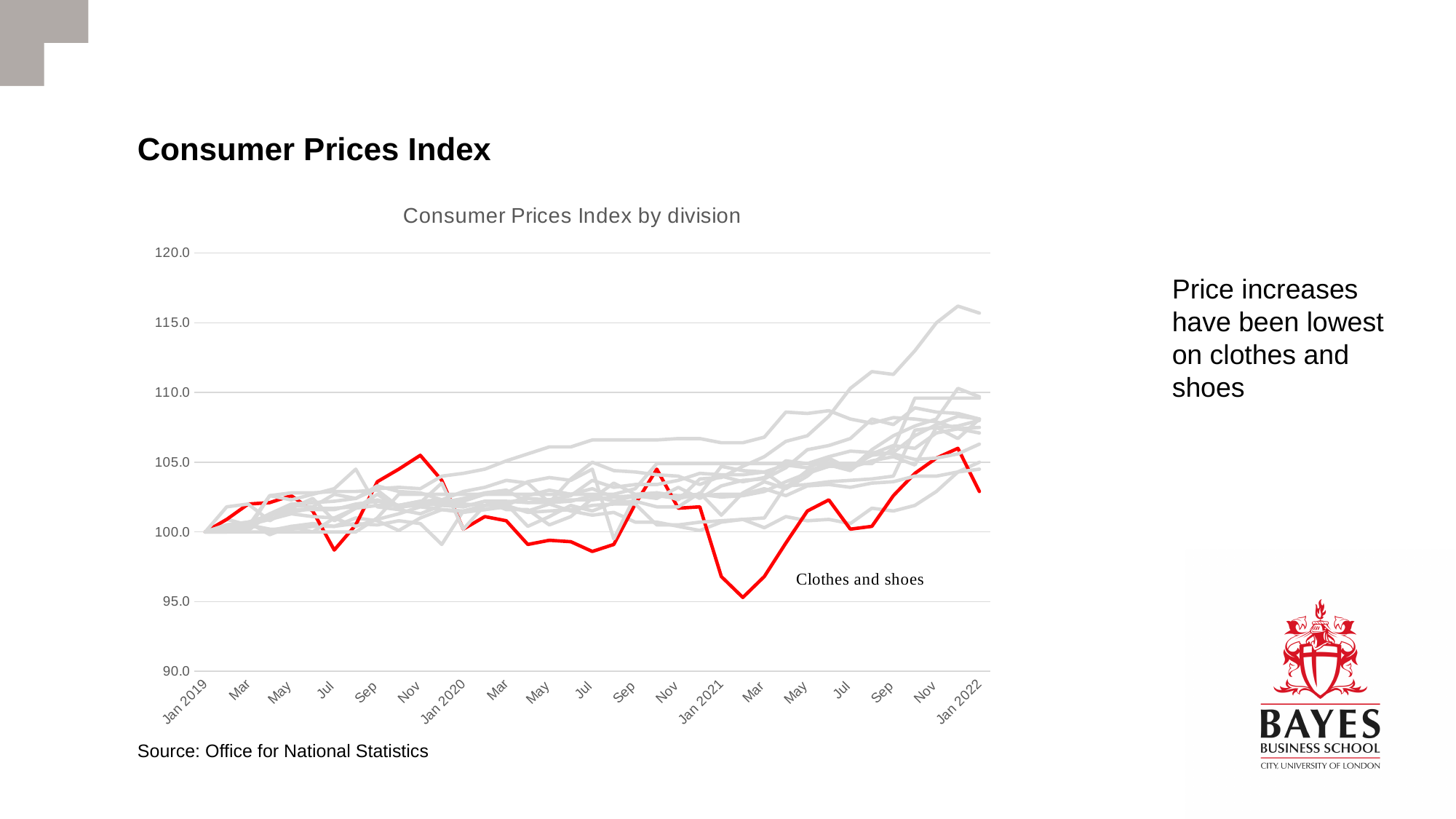
What is the value for Clothes and shoes in Jan 2019? 100.0 Is the highest grey line in Dec 2021 greater or less than 110? greater What is the title of the chart? Consumer Prices Index by division Does the Clothes and shoes line rise or fall between Mar 2021 and Jun 2021? Rise Which series is drawn in red on the chart? Clothes and shoes What is the lowest value shown on the y axis? 90.0 Is the value for Clothes and shoes in Mar 2021 greater or less than 100? less What kind of chart is shown on the slide? Line chart What is the highest value shown on the y axis? 120.0 Is the value for Clothes and shoes in Jan 2022 greater or less than 105? less